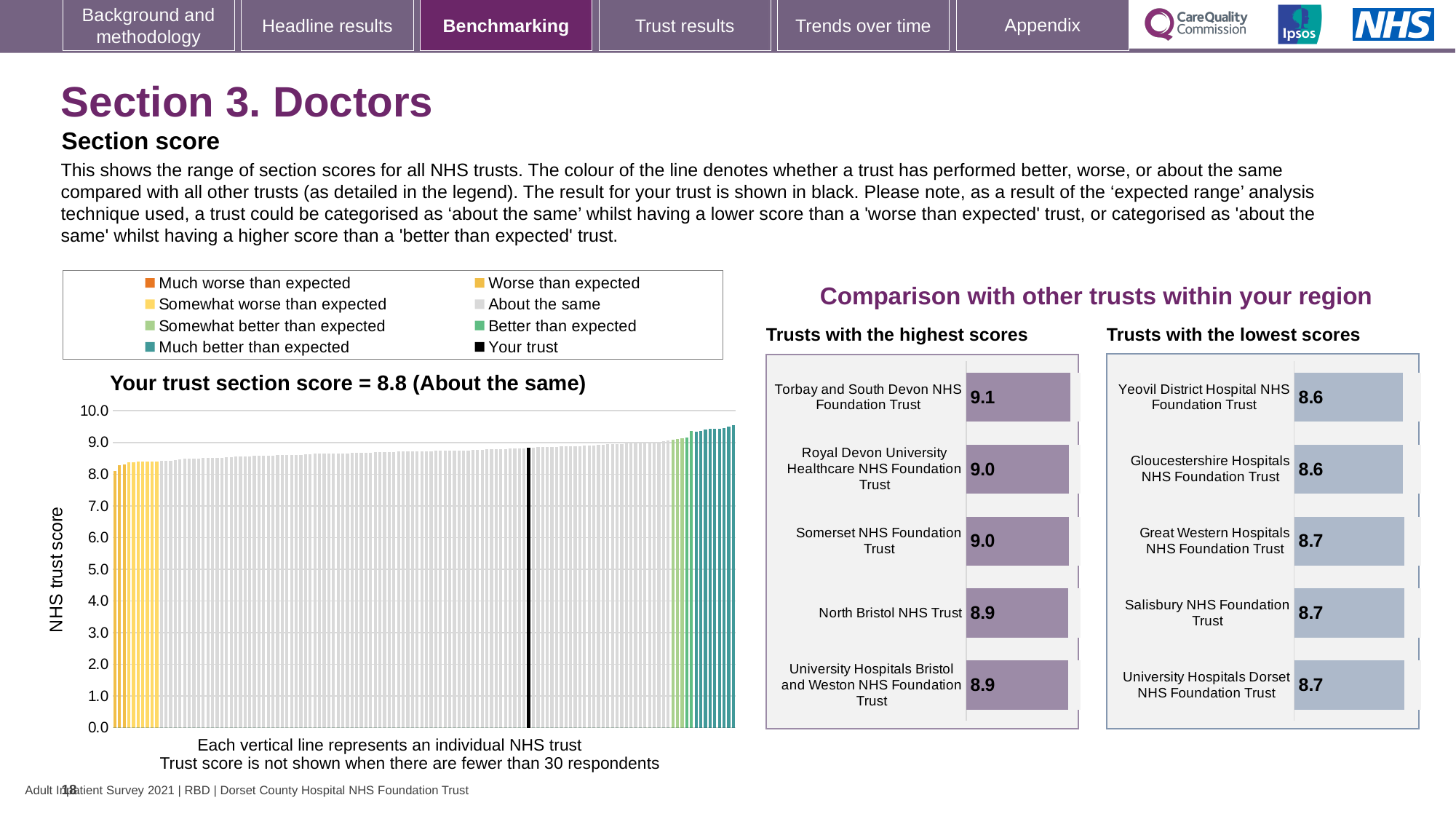
In the 'Trusts with the highest scores' chart, what is the difference between the scores of Torbay and South Devon NHS Foundation Trust and North Bristol NHS Trust? 0.2 How many trusts are listed in the 'Trusts with the highest scores' chart? 5 In the 'Trusts with the highest scores' chart, what is the score for Torbay and South Devon NHS Foundation Trust? 9.1 In the 'Trusts with the lowest scores' chart, what is the score for Salisbury NHS Foundation Trust? 8.7 In the 'Trusts with the lowest scores' chart, what is the score for Yeovil District Hospital NHS Foundation Trust? 8.6 What is the label on the vertical axis of the 'Your trust section score' chart? NHS trust score What kind of chart is the 'Your trust section score' chart on the left of the slide? Bar chart How many entries does the legend above the 'Your trust section score' chart list? 8 According to the chart title on the left, what is your trust's section score? 8.8 In the 'Trusts with the highest scores' chart, which trust has the highest score? Torbay and South Devon NHS Foundation Trust How many trusts are listed in the 'Trusts with the lowest scores' chart? 5 In the 'Trusts with the lowest scores' chart, which has the larger score: Great Western Hospitals NHS Foundation Trust or Yeovil District Hospital NHS Foundation Trust? Great Western Hospitals NHS Foundation Trust